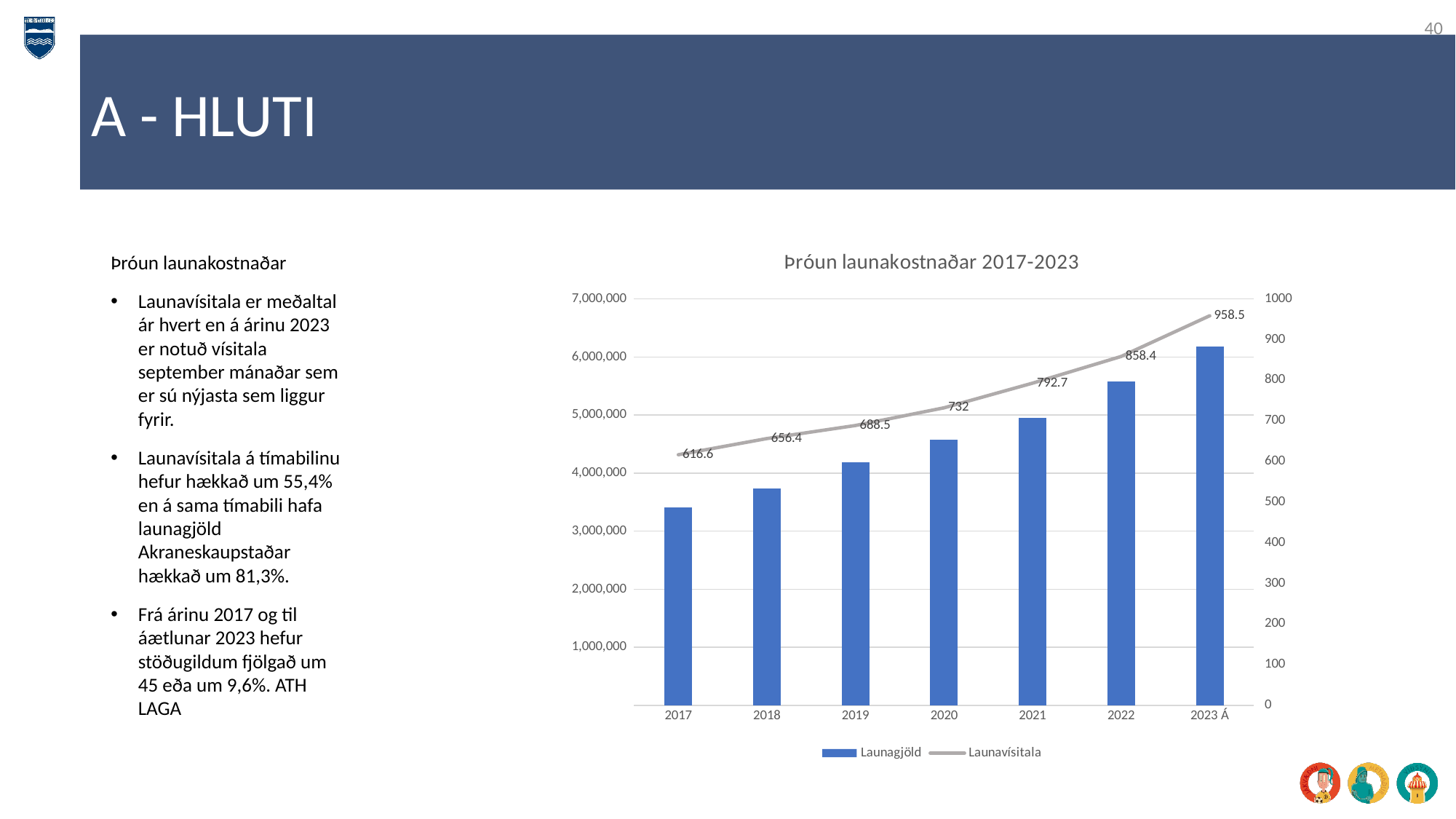
How many years are shown on the x axis? 7 What is the Launavísitala value for 2017? 616.6 Do the Launagjöld bars rise or fall from 2017 to 2023 Á? rise Which year has the highest Launavísitala value? 2023 Á What is the Launavísitala value for 2019? 688.5 Is the Launagjöld value for 2022 greater or less than 5,000,000? greater Which year has the lowest Launagjöld bar? 2017 What is the Launavísitala value for 2023 Á? 958.5 Is the Launagjöld value for 2018 greater or less than 4,000,000? less Which is larger, the Launagjöld bar for 2020 or for 2021? 2021 How many series does the legend list? 2 What is the difference between the Launavísitala values for 2022 and 2021? 65.7